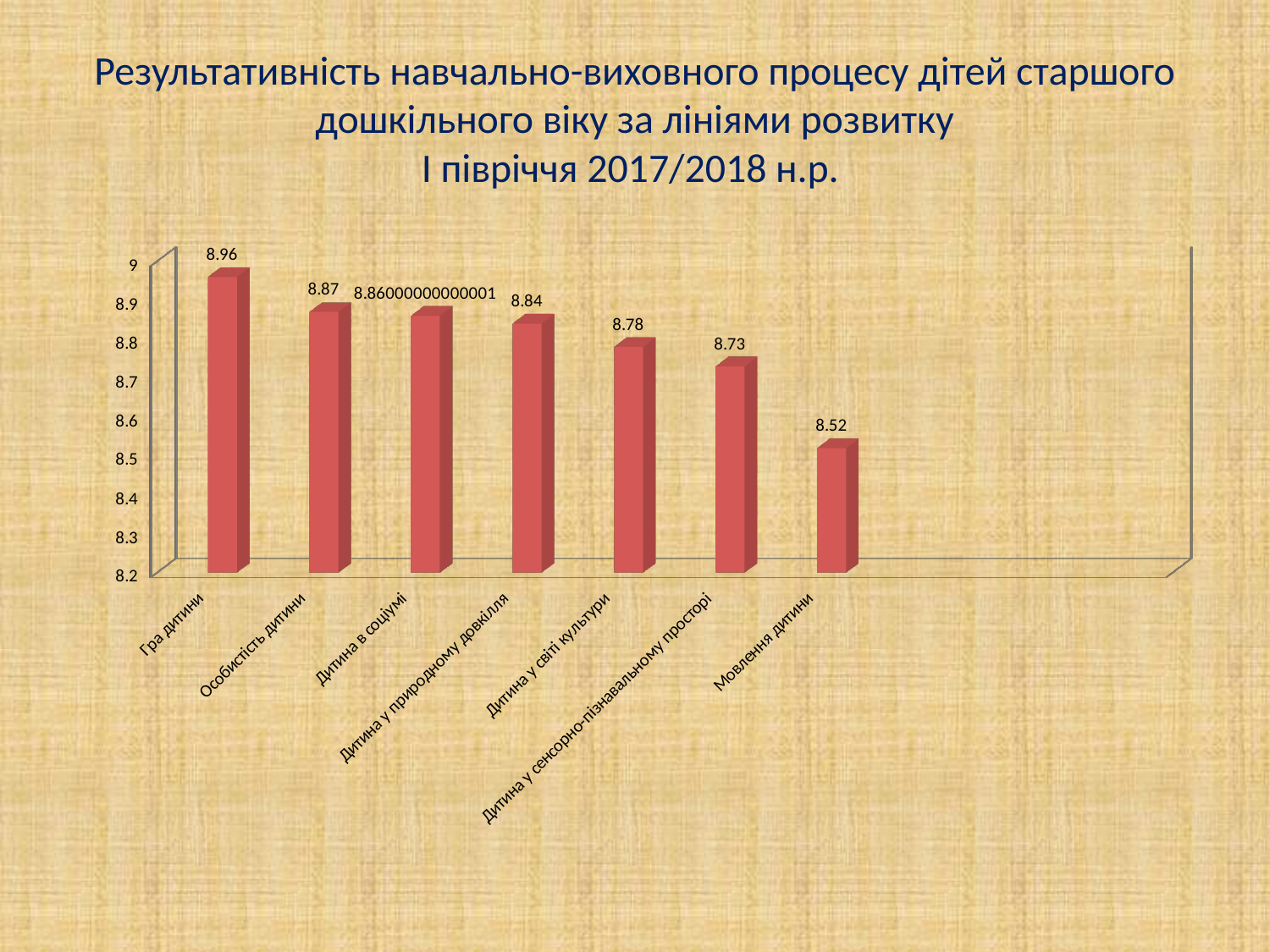
Which category has the lowest value? Мовлення дитини What is the value for Гра дитини? 8.96 What kind of chart is shown on the slide? bar chart Is the value for Мовлення дитини greater or less than 8.6? less What is the value for Дитина у сенсорно-пізнавальному просторі? 8.73 How many categories are shown in the chart? 7 What value is printed above the bar for Дитина в соціумі? 8.86000000000001 What is the difference between the values for Особистість дитини and Дитина у світі культури? 0.09 What is the value for Мовлення дитини? 8.52 What is the difference between the values for Гра дитини and Мовлення дитини? 0.44 Which is larger, the value for Дитина у природному довкіллі or the value for Дитина у сенсорно-пізнавальному просторі? Дитина у природному довкіллі Which category has the highest value? Гра дитини